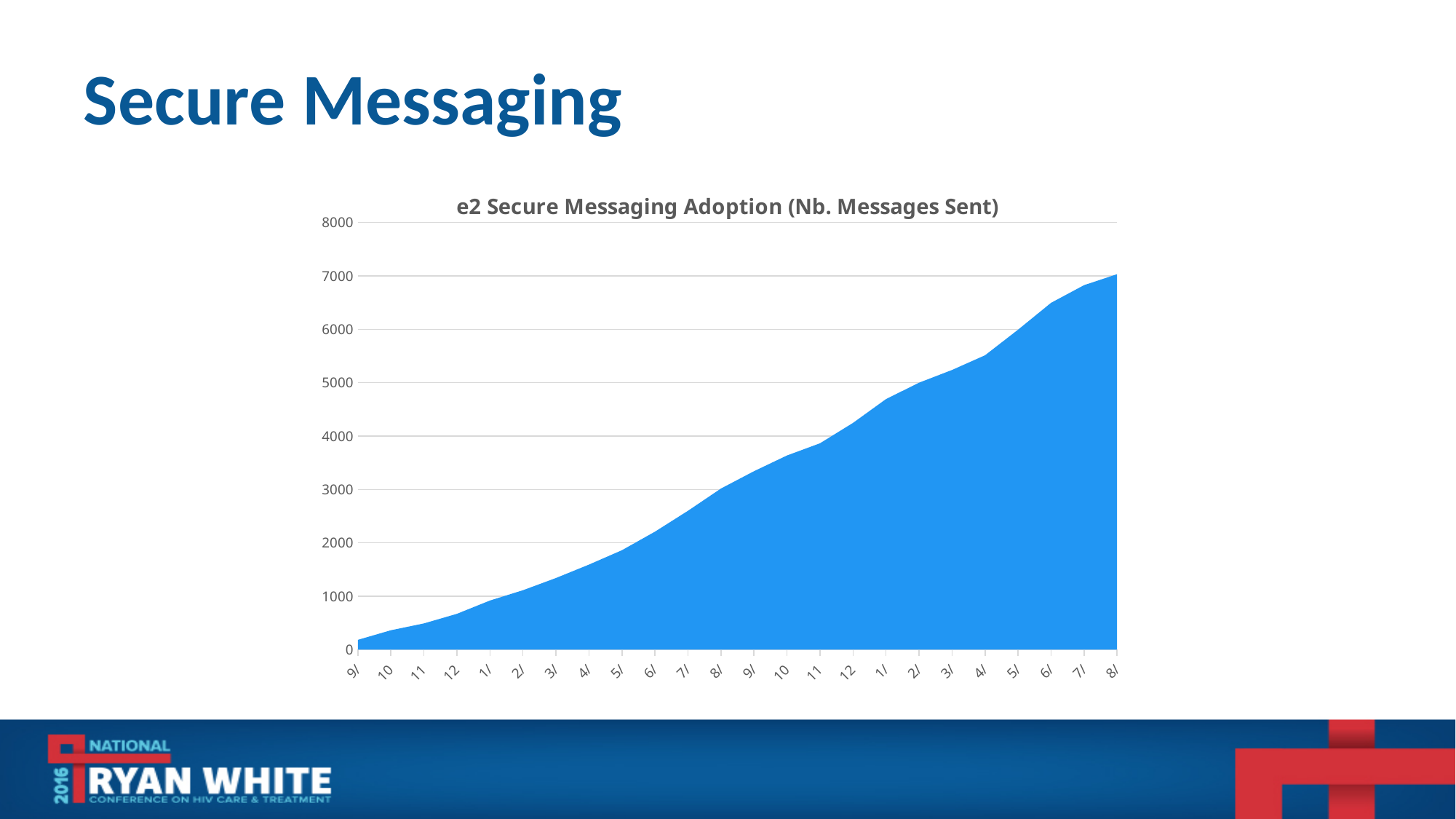
Where on the x axis does the lowest value occur? at the first (leftmost) point Is the value at the midpoint of the series (the 12th point, labelled 8/) greater or less than 4000? less Is the value at the first (leftmost) point greater or less than 1000? less What is the highest value shown on the y axis? 8000 Does the series ever exceed 8000? no How many data points are plotted along the x axis? 24 Which point has the highest value, the first or the last? the last What is the title of the chart? e2 Secure Messaging Adoption (Nb. Messages Sent) Do the values rise or fall from left to right along the x axis? rise What kind of chart is shown on the slide? area chart